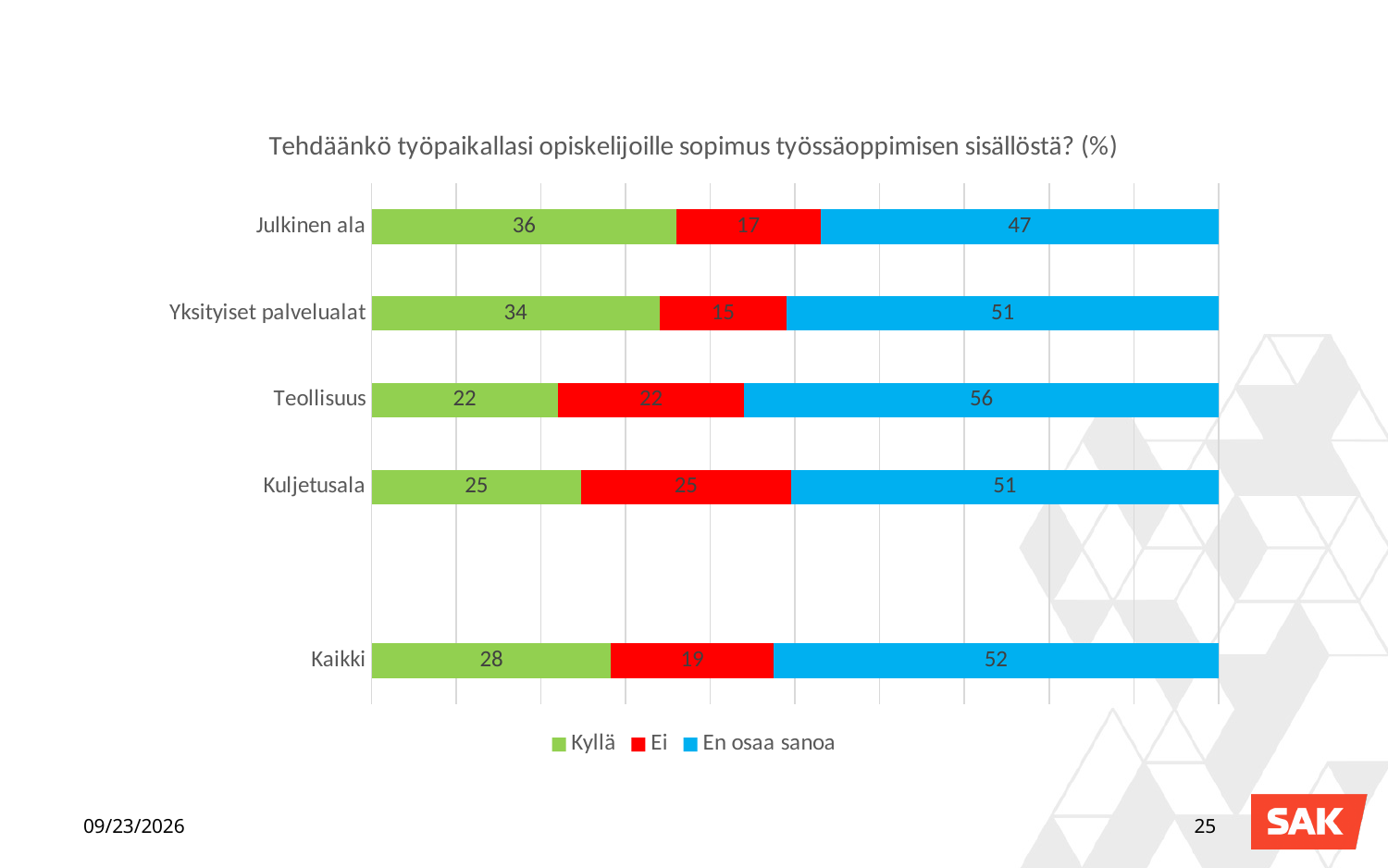
What is the 'Kyllä' value for Julkinen ala? 36 What kind of chart is shown on the slide? Stacked bar chart How many series does the legend list? 3 Which category has the lowest 'Ei' value? Yksityiset palvelualat What is the difference between the 'Kyllä' values for Julkinen ala and Teollisuus? 14 Which colour represents the 'Ei' series? Red What is the 'Ei' value for Kaikki? 19 What is the total of the stacked bar for Kuljetusala? 101 Which is larger: the 'En osaa sanoa' value for Teollisuus or for Julkinen ala? Teollisuus Which category has the highest 'Kyllä' value? Julkinen ala How many categories are shown on the chart? 5 What is the 'En osaa sanoa' value for Teollisuus? 56